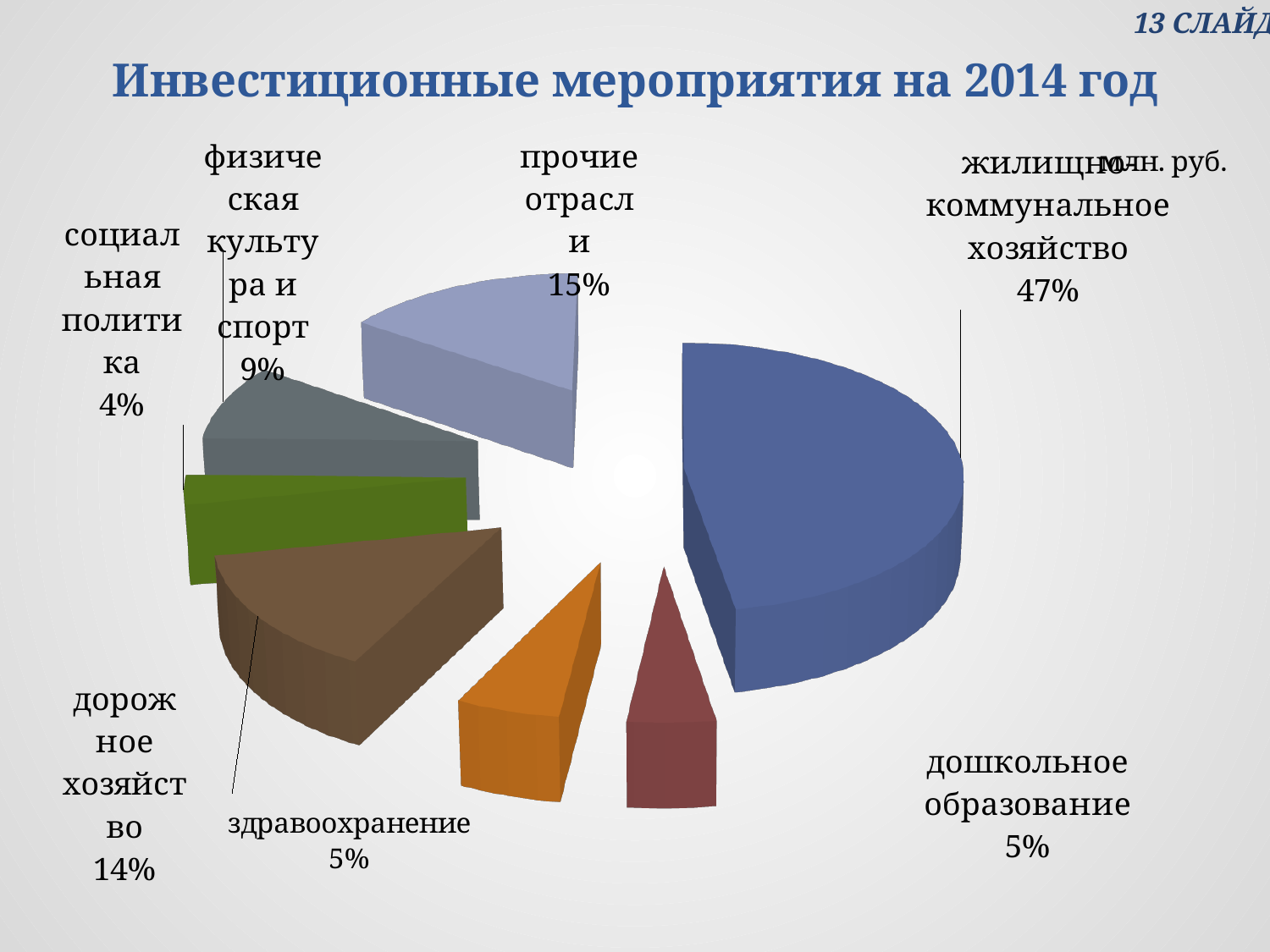
Which category has the largest slice of the pie? жилищно-коммунальное хозяйство How many slices does the pie chart have? 7 Which category has the smallest slice of the pie? социальная политика What percentage is shown for прочие отрасли? 15% What is the difference in percentage points between жилищно-коммунальное хозяйство and прочие отрасли? 32 What percentage is shown for дорожное хозяйство? 14% Which is larger: дорожное хозяйство or физическая культура и спорт? дорожное хозяйство What is the title of the chart? Инвестиционные мероприятия на 2014 год What percentage is shown for физическая культура и спорт? 9% What kind of chart is shown on the slide? pie chart What share of the pie does жилищно-коммунальное хозяйство have? 47% What percentage is shown for дошкольное образование? 5%